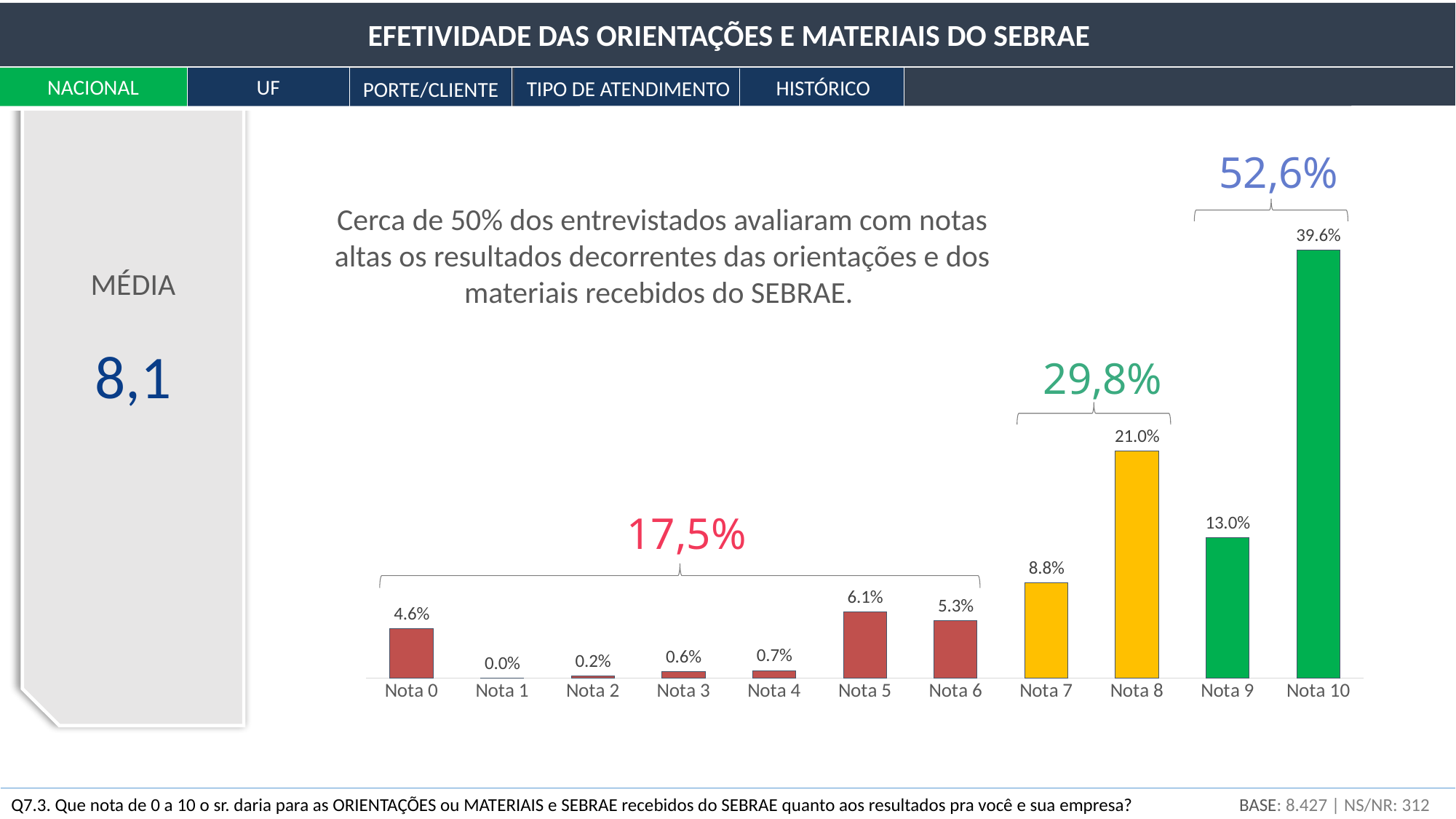
Which category has the lowest value? Nota 1 Which is larger, the value for Nota 5 or the value for Nota 6? Nota 5 What is the value for Nota 0? 4.6% How many categories are shown on the x axis? 11 What kind of chart is shown on the slide? Bar chart What is the value for Nota 8? 21.0% What is the combined share shown above the bracket covering Nota 7 and Nota 8? 29,8% What is the difference between the values for Nota 9 and Nota 7? 4.2% What is the difference between the values for Nota 10 and Nota 8? 18.6% What is the value for Nota 10? 39.6% What is the combined share shown above the bracket covering Nota 9 and Nota 10? 52,6% Which category has the highest value? Nota 10